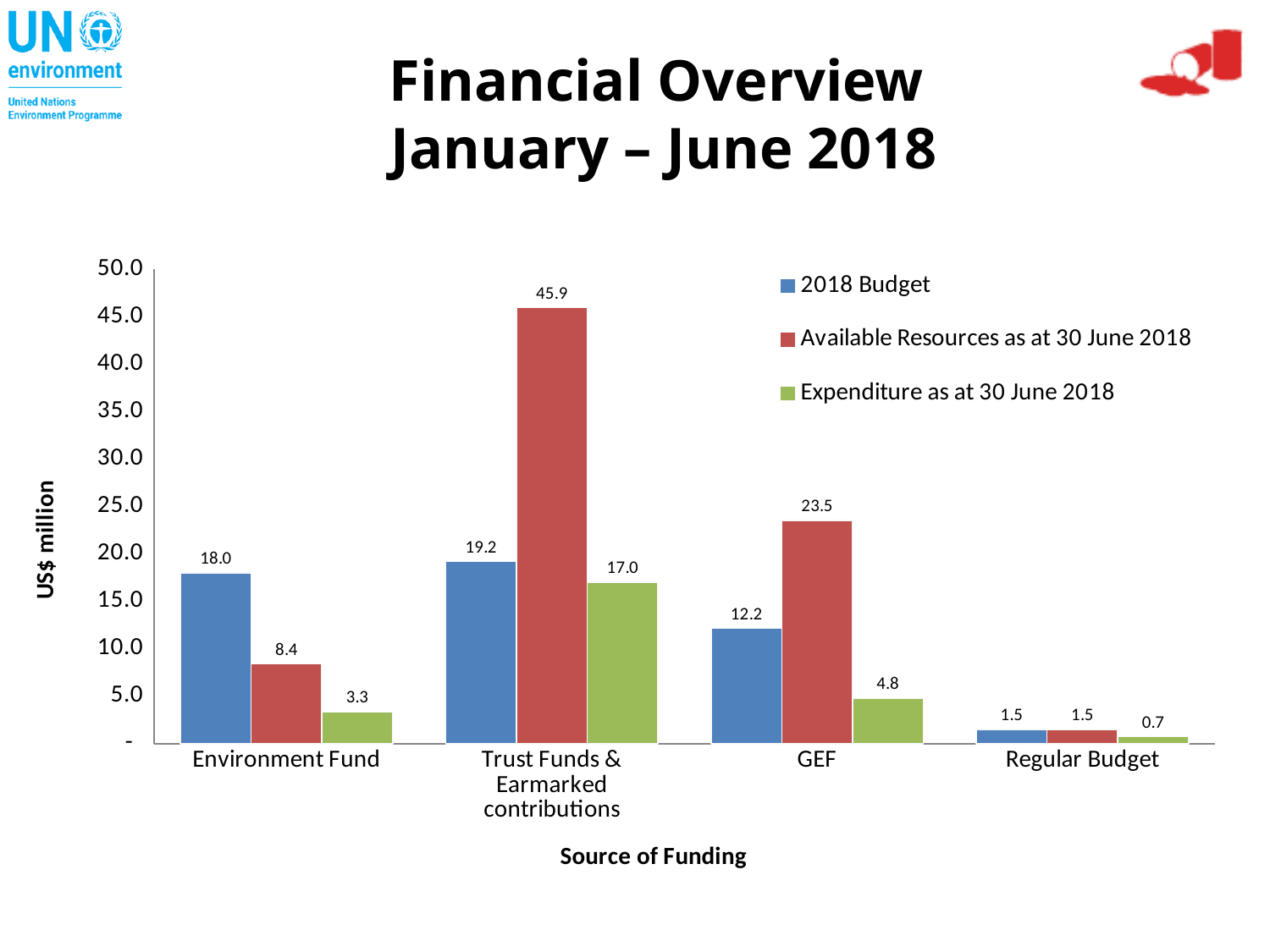
What is the difference between the 2018 Budget and the Available Resources as at 30 June 2018 for the Environment Fund? 9.6 Which source of funding has the lowest 2018 Budget? Regular Budget What is the Expenditure as at 30 June 2018 value for GEF? 4.8 What is the label of the y axis? US$ million What is the Available Resources as at 30 June 2018 value for Trust Funds & Earmarked contributions? 45.9 What is the Expenditure as at 30 June 2018 value for the Regular Budget? 0.7 What is the 2018 Budget value for the Environment Fund? 18.0 Which source of funding has the highest Available Resources as at 30 June 2018? Trust Funds & Earmarked contributions What kind of chart is shown on the slide? Bar chart Which is larger for GEF: the 2018 Budget or the Available Resources as at 30 June 2018? Available Resources as at 30 June 2018 How many sources of funding are shown on the x axis? 4 How many series does the legend list? 3